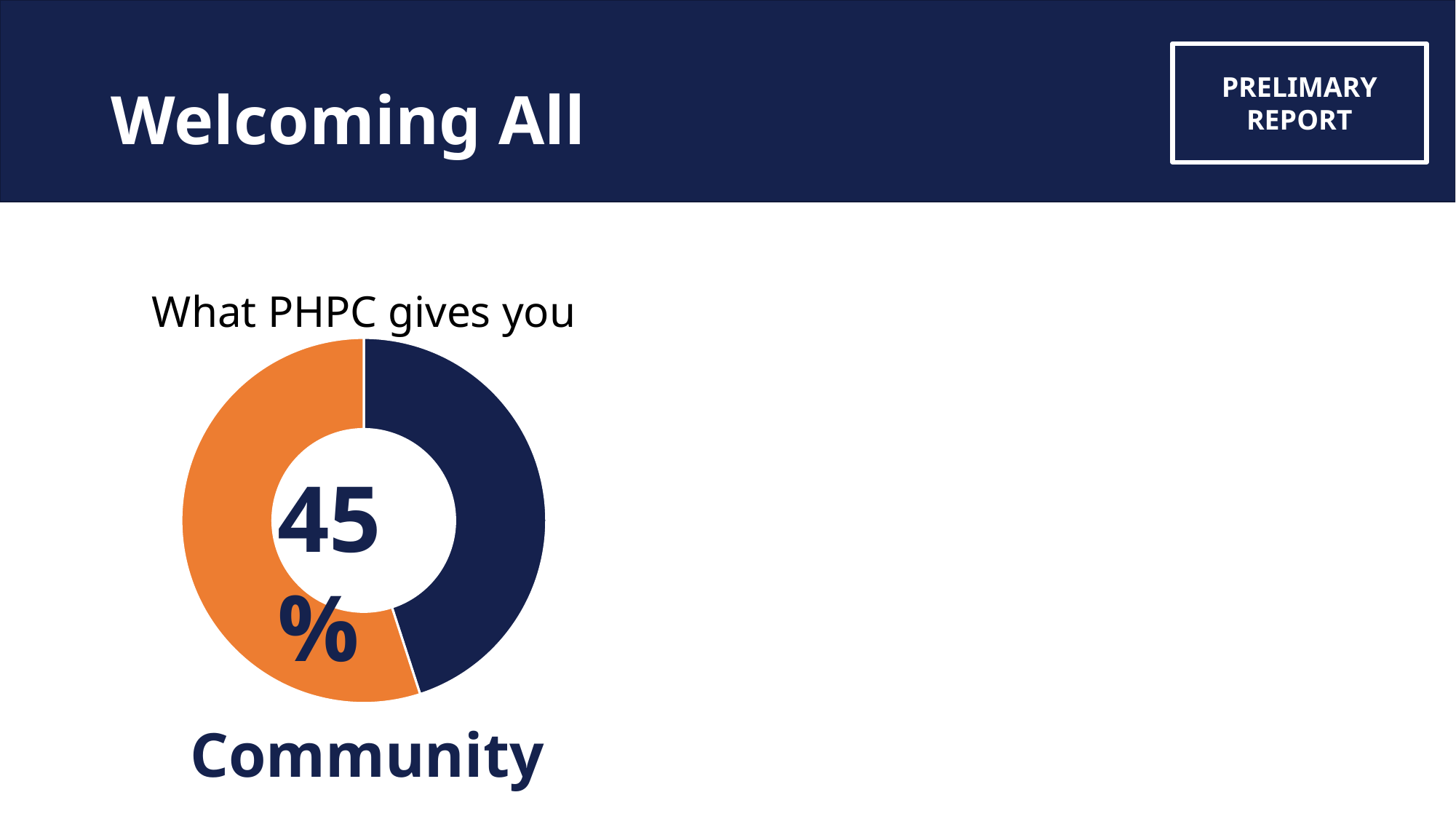
Is the navy slice's share of the donut greater or less than 50%? less Which slice of the donut chart is larger, the navy one or the orange one? Orange What label appears beneath the donut chart? Community How many slices does the donut chart have? 2 What is the title of the chart? What PHPC gives you Is the orange slice's share of the donut greater or less than 50%? greater Which slice of the donut chart is the smallest? Navy What percentage is printed in the centre of the donut chart? 45% What kind of chart is shown on the slide? Pie chart (donut) What share of the donut does the navy slice represent? 45%